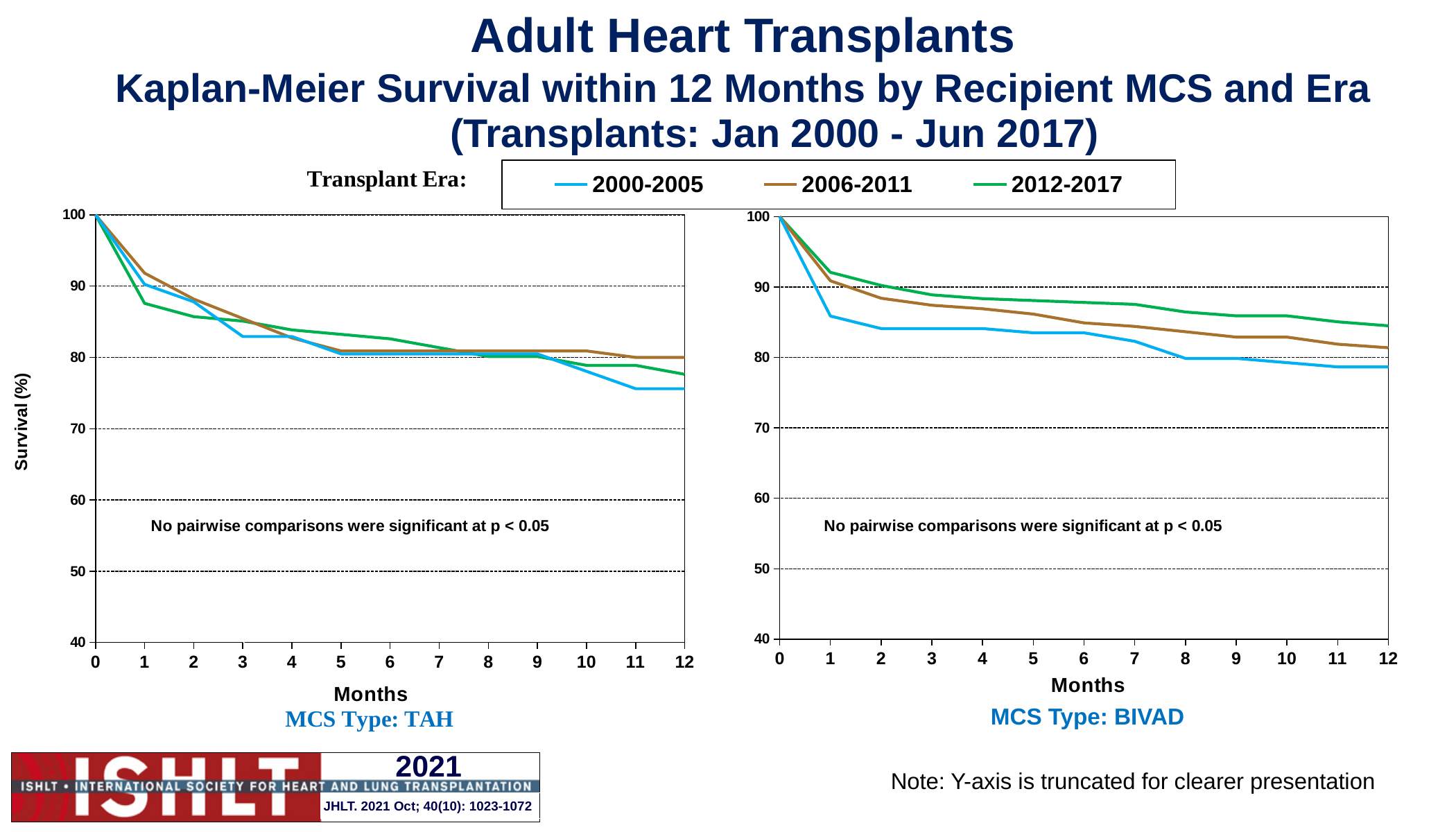
What kind of chart is the MCS Type: TAH chart? line chart In the MCS Type: TAH chart, do the survival curves rise or fall as months increase? fall In the MCS Type: BIVAD chart, which era has the highest survival at month 12? 2012-2017 In the MCS Type: BIVAD chart, what is the survival value for all eras at month 0? 100 In the MCS Type: BIVAD chart, at month 12, which era has higher survival: 2000-2005 or 2012-2017? 2012-2017 In the MCS Type: BIVAD chart, is the survival for 2012-2017 at month 12 greater or less than 80? greater In the MCS Type: TAH chart, is the survival for 2000-2005 at month 12 greater or less than 80? less In the MCS Type: TAH chart, is the survival for 2012-2017 at month 1 greater or less than 90? less In the MCS Type: TAH chart, which era has the lowest survival at month 12? 2000-2005 What is the label of the y-axis on the charts? Survival (%) How many transplant eras does the legend list? 3